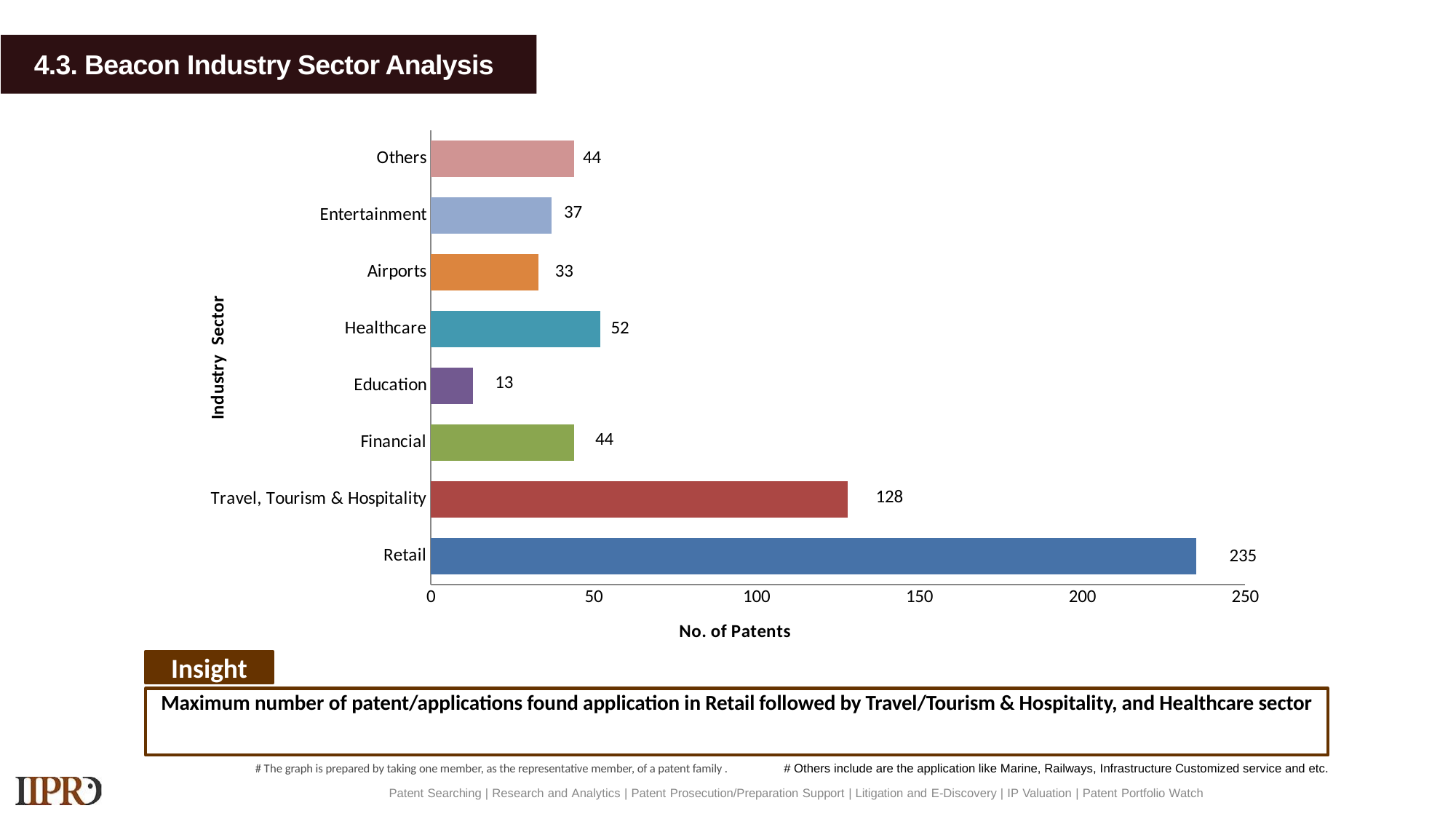
How many industry sectors are shown in the chart? 8 Which has more patents, Entertainment or Airports? Entertainment Is the value for Travel, Tourism & Hospitality greater or less than 100? greater What is the label of the horizontal axis of the chart? No. of Patents What is the difference in number of patents between Retail and Travel, Tourism & Hospitality? 107 What is the number of patents for Retail? 235 Which industry sector has the highest number of patents? Retail What is the number of patents for Healthcare? 52 What type of chart is shown on the slide? Bar chart What is the number of patents for Travel, Tourism & Hospitality? 128 What is the number of patents for Education? 13 Which industry sector has the lowest number of patents? Education